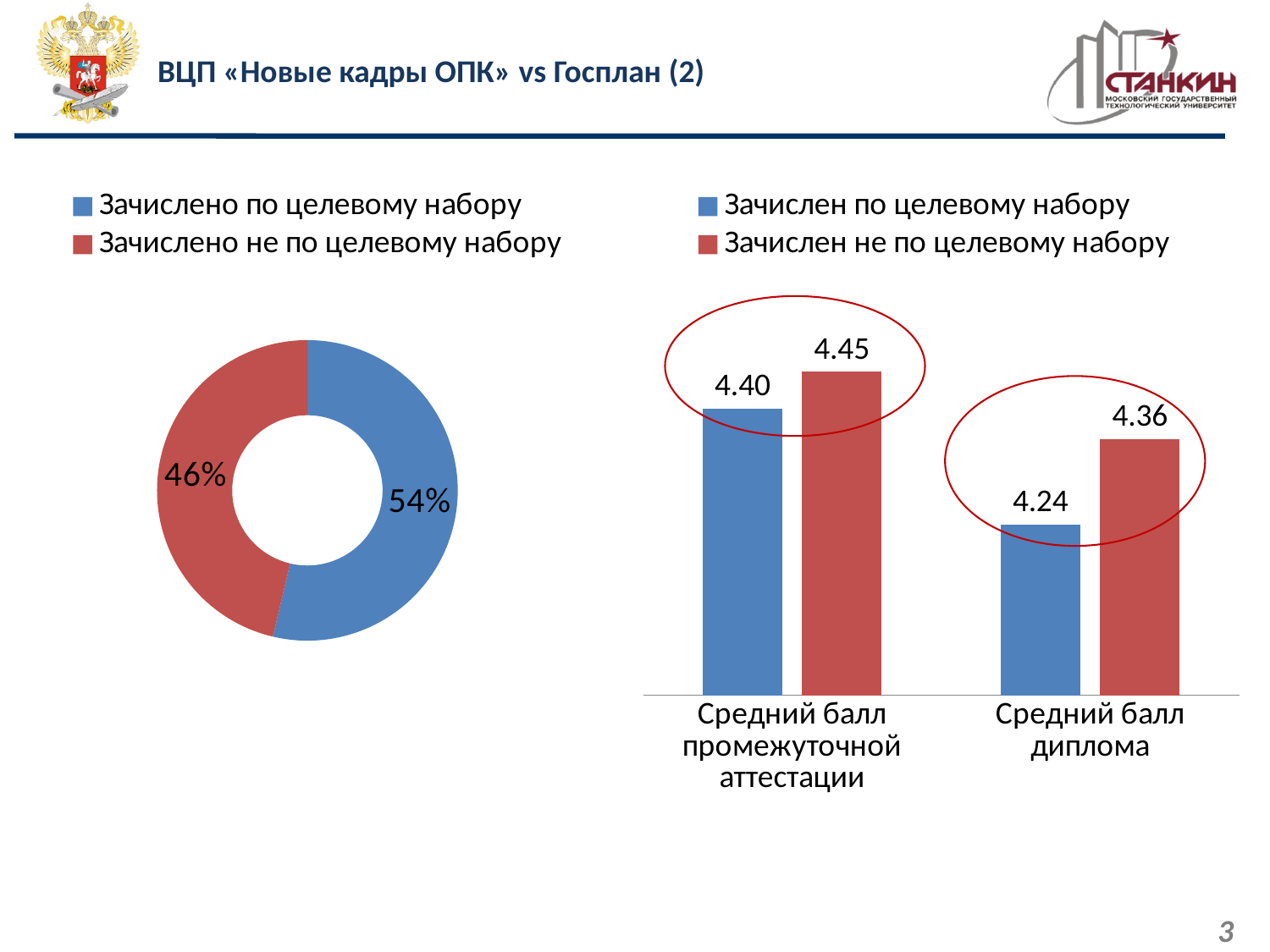
In the doughnut chart on the left, what share is labelled for the red slice (Зачислено не по целевому набору)? 46% In the doughnut chart on the left, what share is labelled for the blue slice (Зачислено по целевому набору)? 54% In the bar chart on the right, what is the value for Зачислен по целевому набору for Средний балл промежуточной аттестации? 4.40 In the bar chart on the right, what is the value for Зачислен не по целевому набору for Средний балл промежуточной аттестации? 4.45 How many series does the legend of the left chart list? 2 What kind of chart is shown on the left of the slide? Doughnut (pie) chart In the bar chart on the right, which bar is the lowest? Зачислен по целевому набору, Средний балл диплома (4.24) In the chart on the left, which slice is larger: Зачислено по целевому набору or Зачислено не по целевому набору? Зачислено по целевому набору In the bar chart on the right, what is the value for Зачислен по целевому набору for Средний балл диплома? 4.24 In the bar chart on the right, what is the value for Зачислен не по целевому набору for Средний балл диплома? 4.36 In the bar chart on the right, what is the difference between the two bars for Средний балл диплома? 0.12 How many categories are shown on the x axis of the bar chart on the right? 2